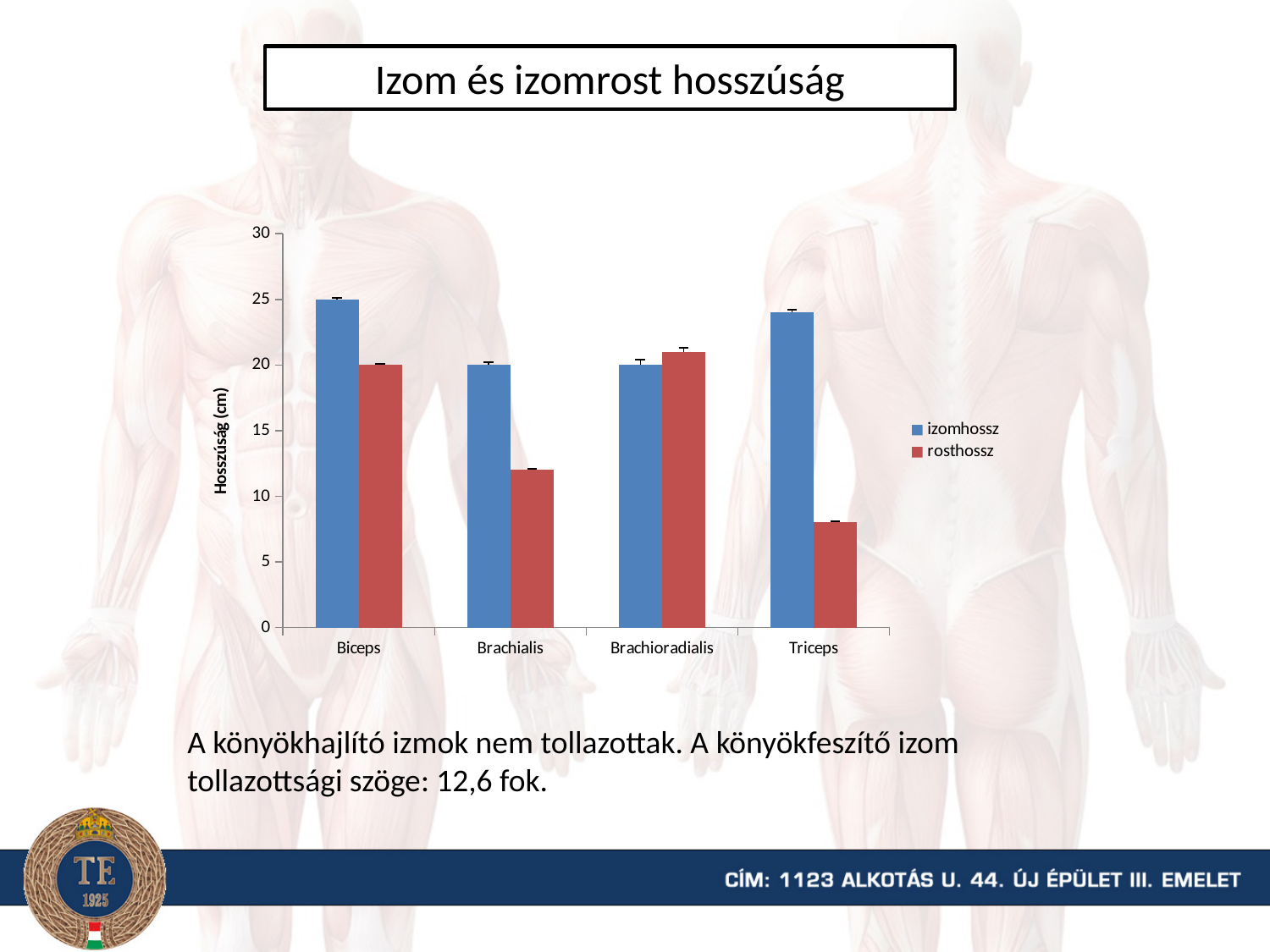
Is the rosthossz value for Triceps greater or less than 10? less Is the izomhossz value for Triceps greater or less than 20? greater What is the difference between izomhossz and rosthossz for Biceps? 5 What is the izomhossz value for Brachialis? 20 What type of chart is shown on the slide? bar chart Which muscle has the lowest rosthossz value? Triceps For Brachialis, which is larger: izomhossz or rosthossz? izomhossz What is the rosthossz value for Biceps? 20 How many series does the legend list? 2 What is the label of the y axis? Hosszúság (cm) What is the izomhossz value for Biceps? 25 How many muscle categories are shown on the x axis? 4